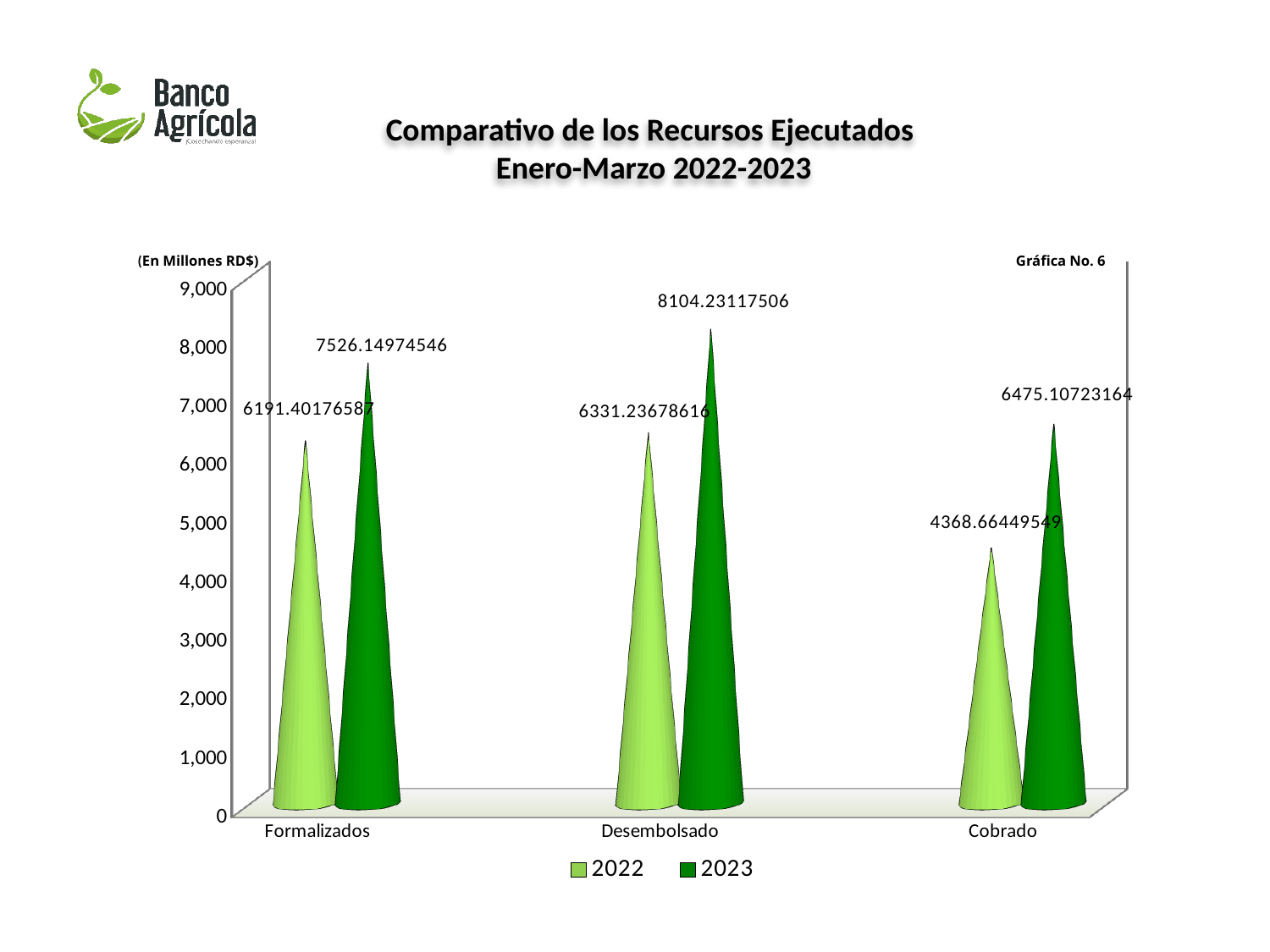
How many categories are shown on the x axis? 3 Which is larger for Desembolsado, the 2022 value or the 2023 value? 2023 What is the value for Cobrado in 2023? 6475.10723164 Is the value for Cobrado in 2022 greater or less than 5,000? less What unit is stated for the values in the chart? En Millones RD$ What is the value for Desembolsado in 2023? 8104.23117506 What is the value for Formalizados in 2022? 6191.40176587 How many series does the legend list? 2 What is the difference between the 2023 and 2022 values for Formalizados? 1334.74797959 Which category has the highest value for 2023? Desembolsado Which category has the lowest value for 2022? Cobrado What is the value for Cobrado in 2022? 4368.66449549